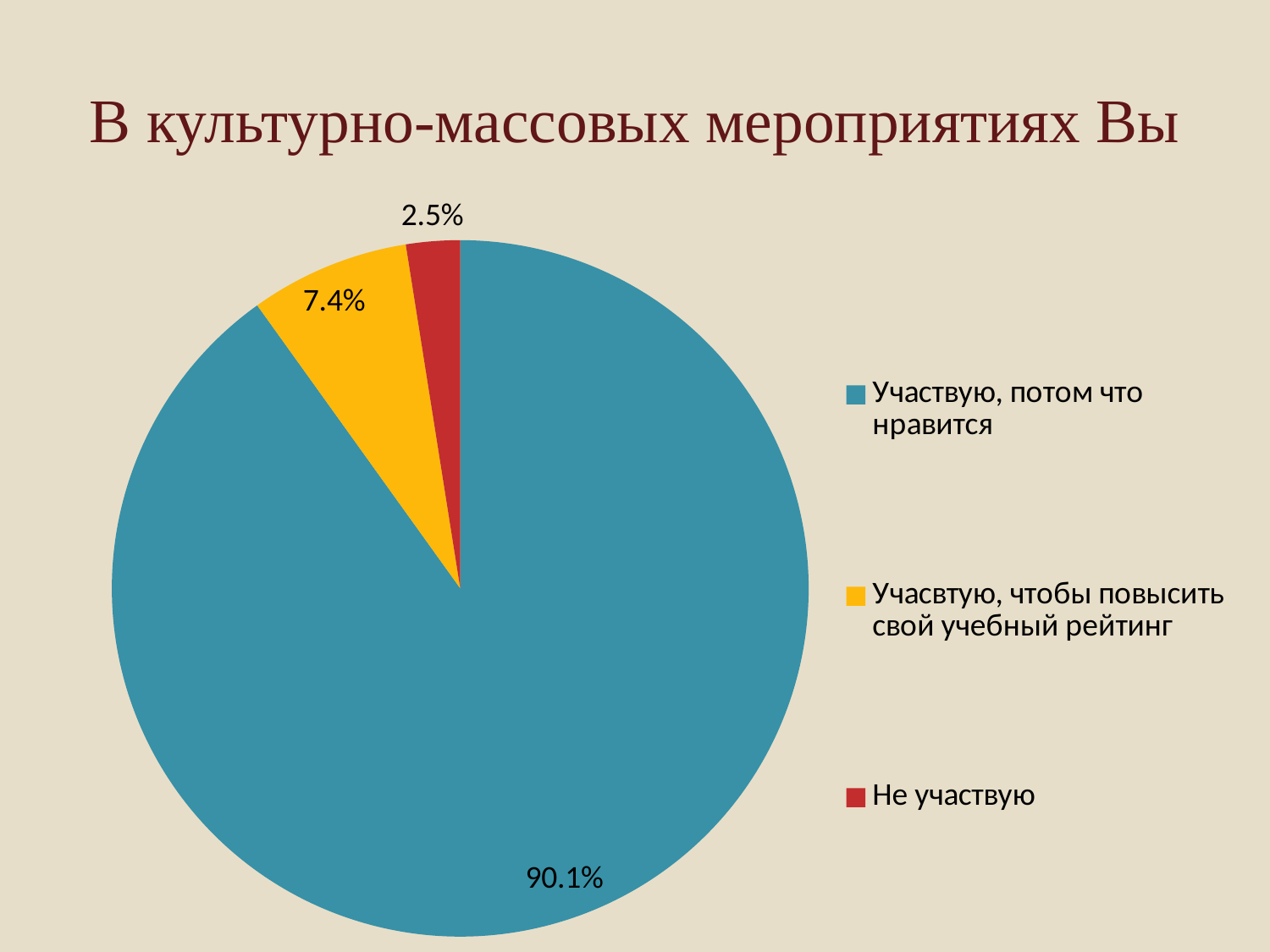
What is the difference in percentage points between "Учасвтую, чтобы повысить свой учебный рейтинг" and "Не участвую"? 4.9 What colour is the slice for "Не участвую"? Red What is the difference in percentage points between "Участвую, потом что нравится" and "Учасвтую, чтобы повысить свой учебный рейтинг"? 82.7 What share of the pie does "Участвую, потом что нравится" take? 90.1% What kind of chart is shown on the slide? Pie chart How many categories does the pie chart show? 3 What is the title of the chart? В культурно-массовых мероприятиях Вы What share of the pie does "Не участвую" take? 2.5% What share of the pie does "Учасвтую, чтобы повысить свой учебный рейтинг" take? 7.4% Which category has the smallest slice of the pie? Не участвую Which category has the largest slice of the pie? Участвую, потом что нравится Which is larger: the slice for "Учасвтую, чтобы повысить свой учебный рейтинг" or the slice for "Не участвую"? Учасвтую, чтобы повысить свой учебный рейтинг